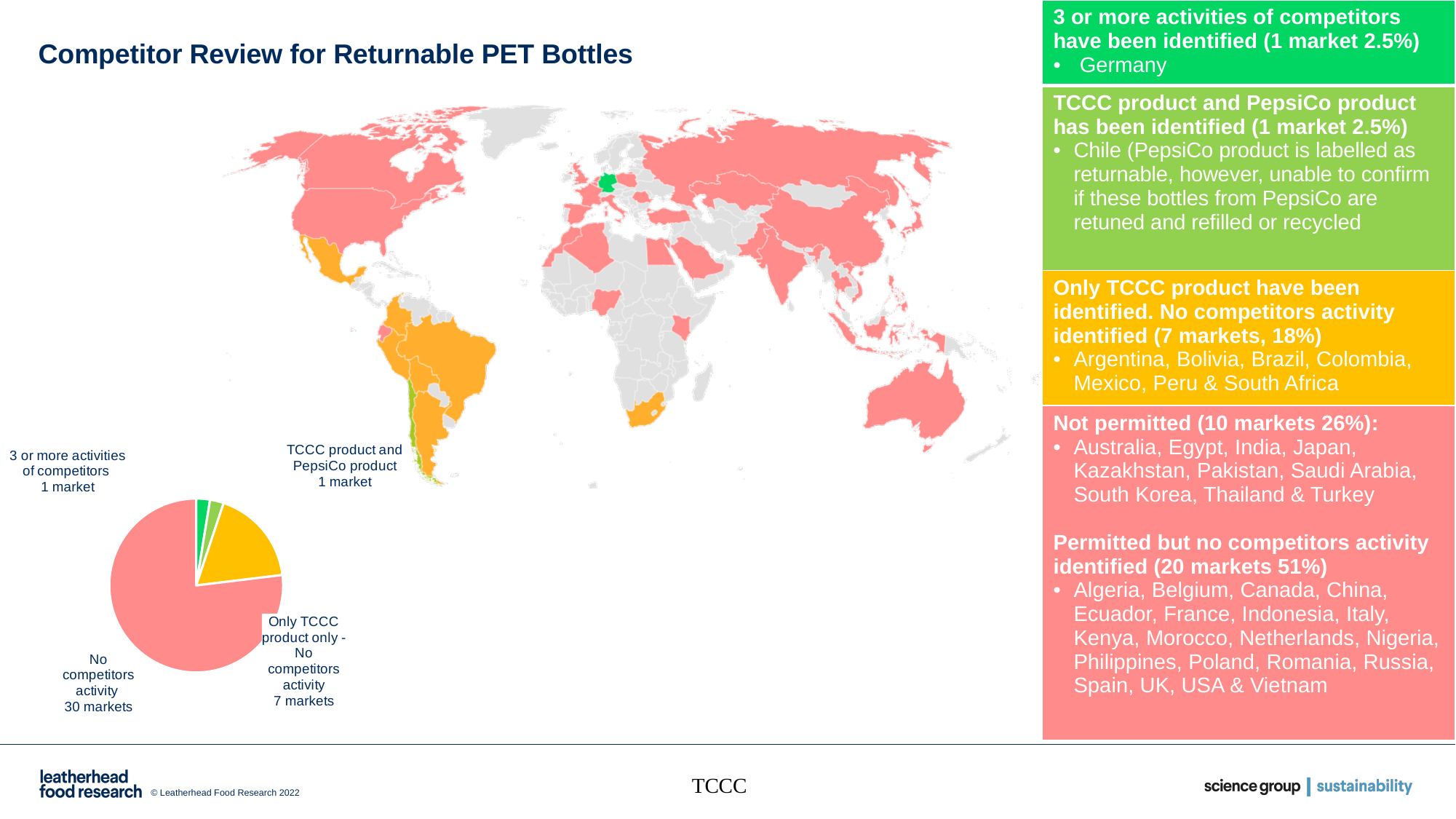
Which slice of the pie chart represents the largest number of markets? No competitors activity What is the title of the slide containing the pie chart? Competitor Review for Returnable PET Bottles How many markets are in the 'Only TCCC product only - No competitors activity' slice of the pie chart? 7 markets Which has more markets in the pie chart: 'Only TCCC product only - No competitors activity' or 'TCCC product and PepsiCo product'? Only TCCC product only - No competitors activity How many markets are in the '3 or more activities of competitors' slice of the pie chart? 1 market How many markets are in the 'TCCC product and PepsiCo product' slice of the pie chart? 1 market How many slices does the pie chart have? 4 What colour is the 'Only TCCC product only - No competitors activity' slice of the pie chart? Yellow How many markets are in the 'No competitors activity' slice of the pie chart? 30 markets What kind of chart is shown at the bottom left of the slide? Pie chart What is the difference in the number of markets between the 'No competitors activity' slice and the 'Only TCCC product only - No competitors activity' slice? 23 markets What is the total number of markets represented across all slices of the pie chart? 39 markets